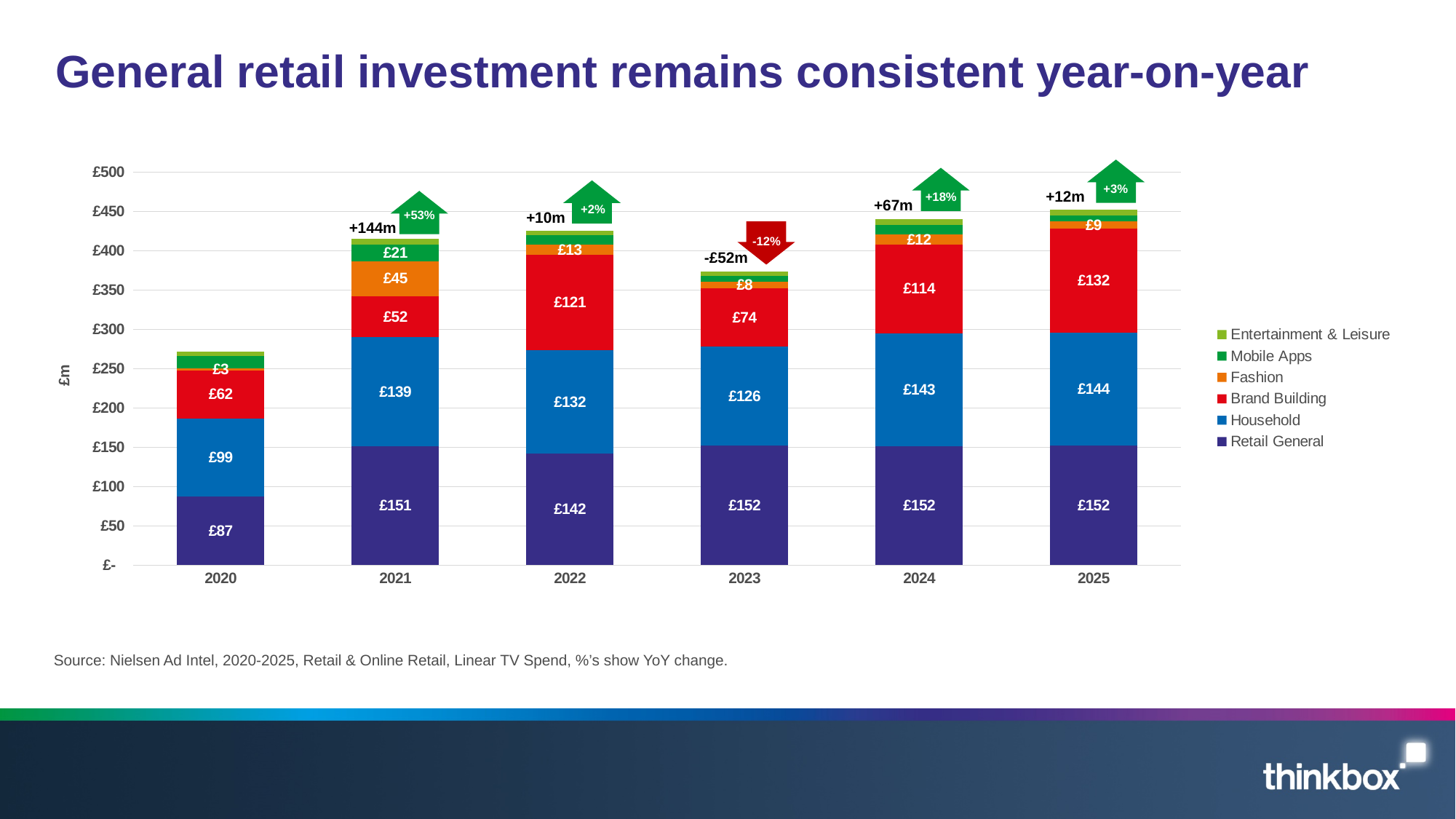
What is the difference between the Household values for 2024 and 2020? £44 What is the Fashion value for 2021? £45 How many years are shown on the x axis? 6 What is the Retail General value for 2020? £87 In which year is the Brand Building value highest? 2025 What is the Household value for 2025? £144 How many series does the legend list? 6 Which year has the larger Brand Building value, 2021 or 2023? 2023 What is the Brand Building value for 2022? £121 What year-on-year percentage change is shown for 2023? -12% Is the total height of the 2020 bar greater or less than £300? less In which year is the Household value lowest? 2020